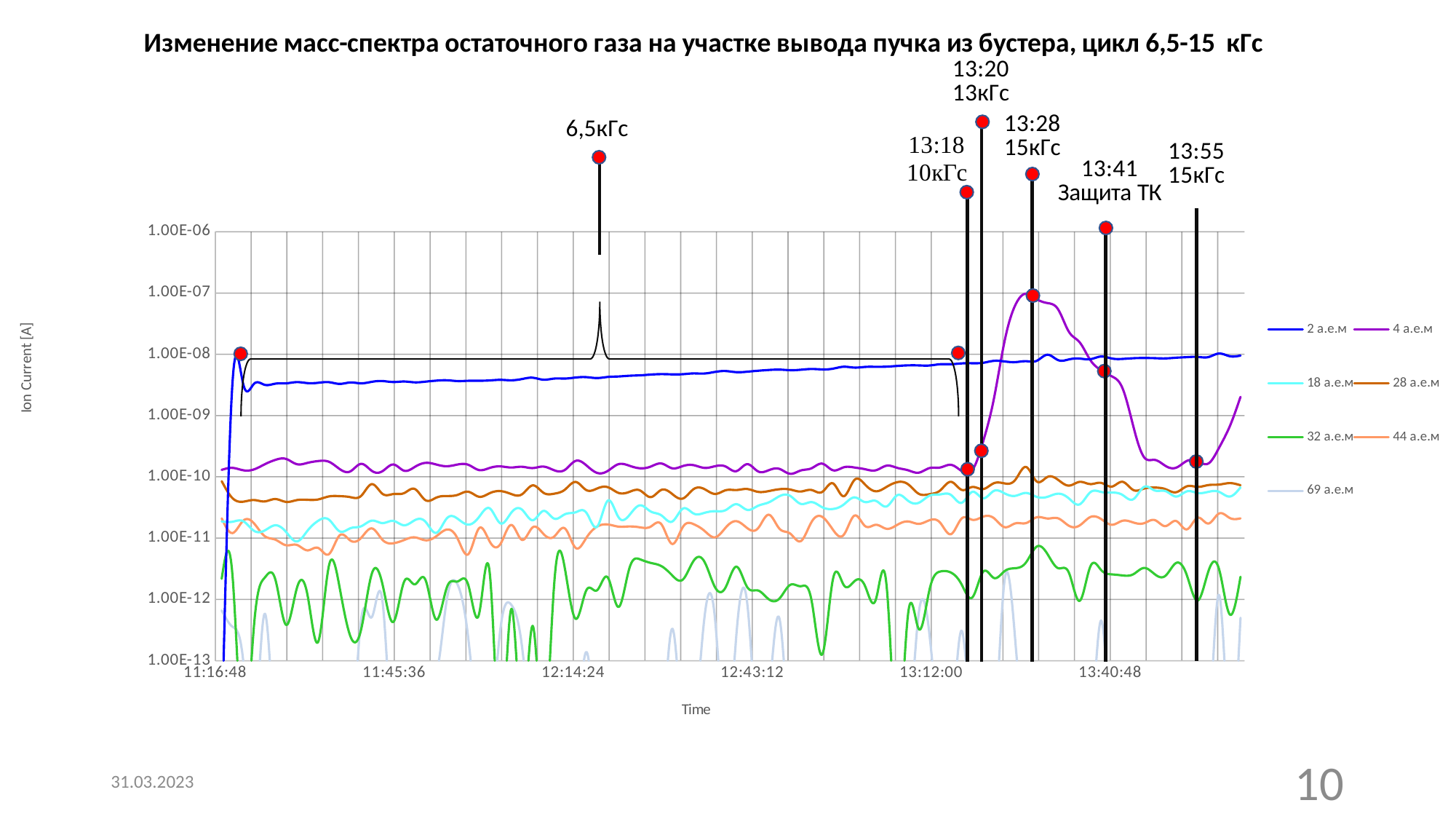
Does the 2 а.е.м series rise or fall overall from 11:45:36 to 13:40:48? rise Which series has the higher value at 12:43:12, 2 а.е.м or 32 а.е.м? 2 а.е.м How many time tick labels are shown on the x axis? 6 Is the value of the 2 а.е.м series at 12:14:24 greater or less than 1.00E-08? less What is the label of the y axis? Ion Current [A] Is the value of the 2 а.е.м series at 12:14:24 greater or less than 1.00E-09? greater Is the value of the 28 а.е.м series at 12:14:24 greater or less than 1.00E-10? less How many series does the legend list? 7 What is the label of the x axis? Time What kind of chart is shown on the slide? line chart Which series has the lowest values across the chart? 69 а.е.м